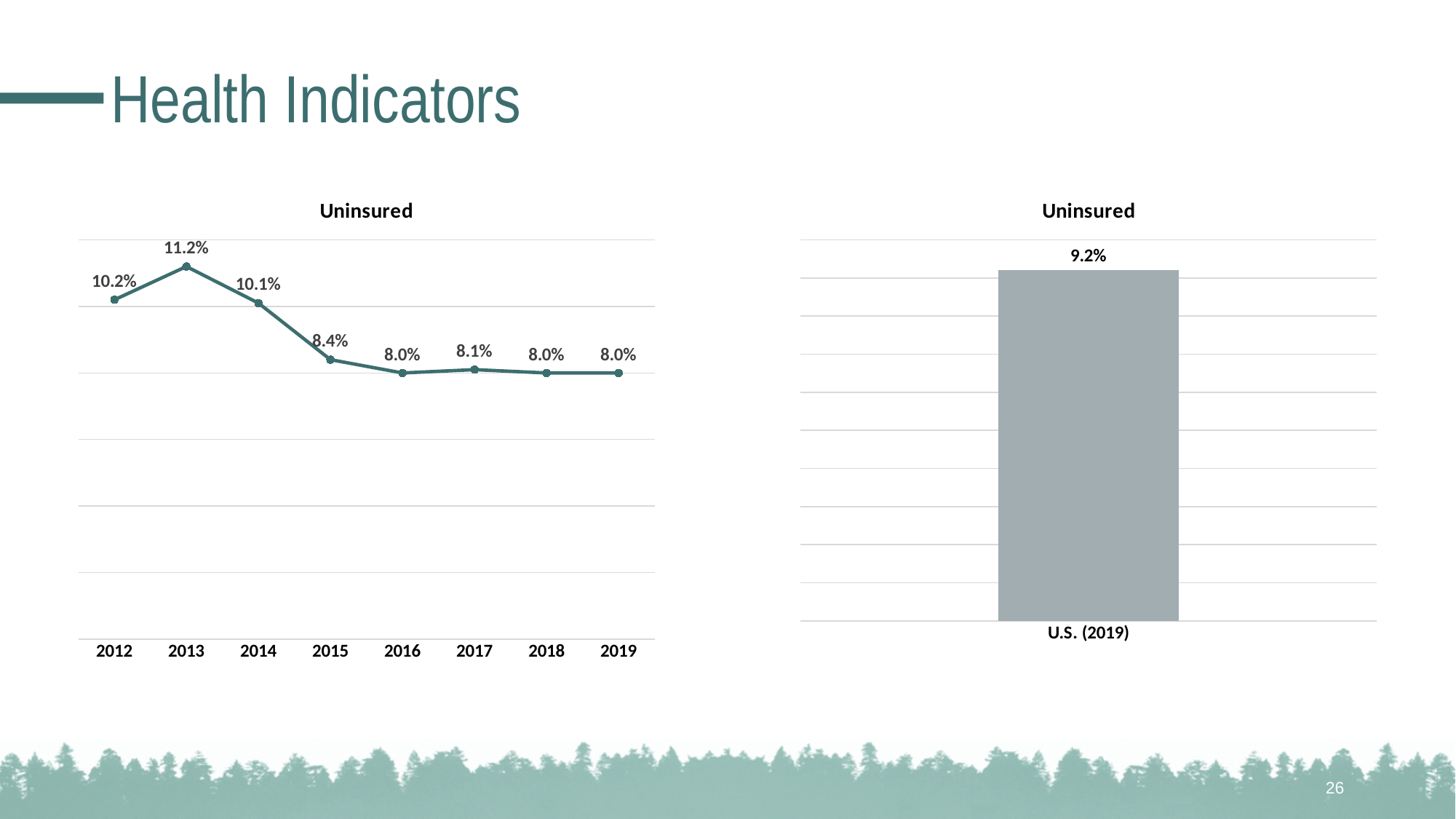
What kind of chart is the left-hand Uninsured chart? Line chart In the left-hand Uninsured line chart, what is the value for 2013? 11.2% In the left-hand Uninsured line chart, what is the value for 2015? 8.4% In the left-hand Uninsured line chart, which is larger, the value for 2012 or the value for 2014? 2012 What is the title of the right-hand chart? Uninsured How many years are plotted in the left-hand Uninsured line chart? 8 In the left-hand Uninsured line chart, do the values generally rise or fall from 2013 to 2016? Fall In the right-hand Uninsured chart, what is the value for U.S. (2019)? 9.2% In the left-hand Uninsured line chart, which year has the highest uninsured rate? 2013 In the left-hand Uninsured line chart, what is the difference between the 2013 value and the 2019 value? 3.2% What kind of chart is the right-hand Uninsured chart? Bar chart Which is larger, the 2019 value in the left-hand line chart or the U.S. (2019) value in the right-hand bar chart? U.S. (2019)